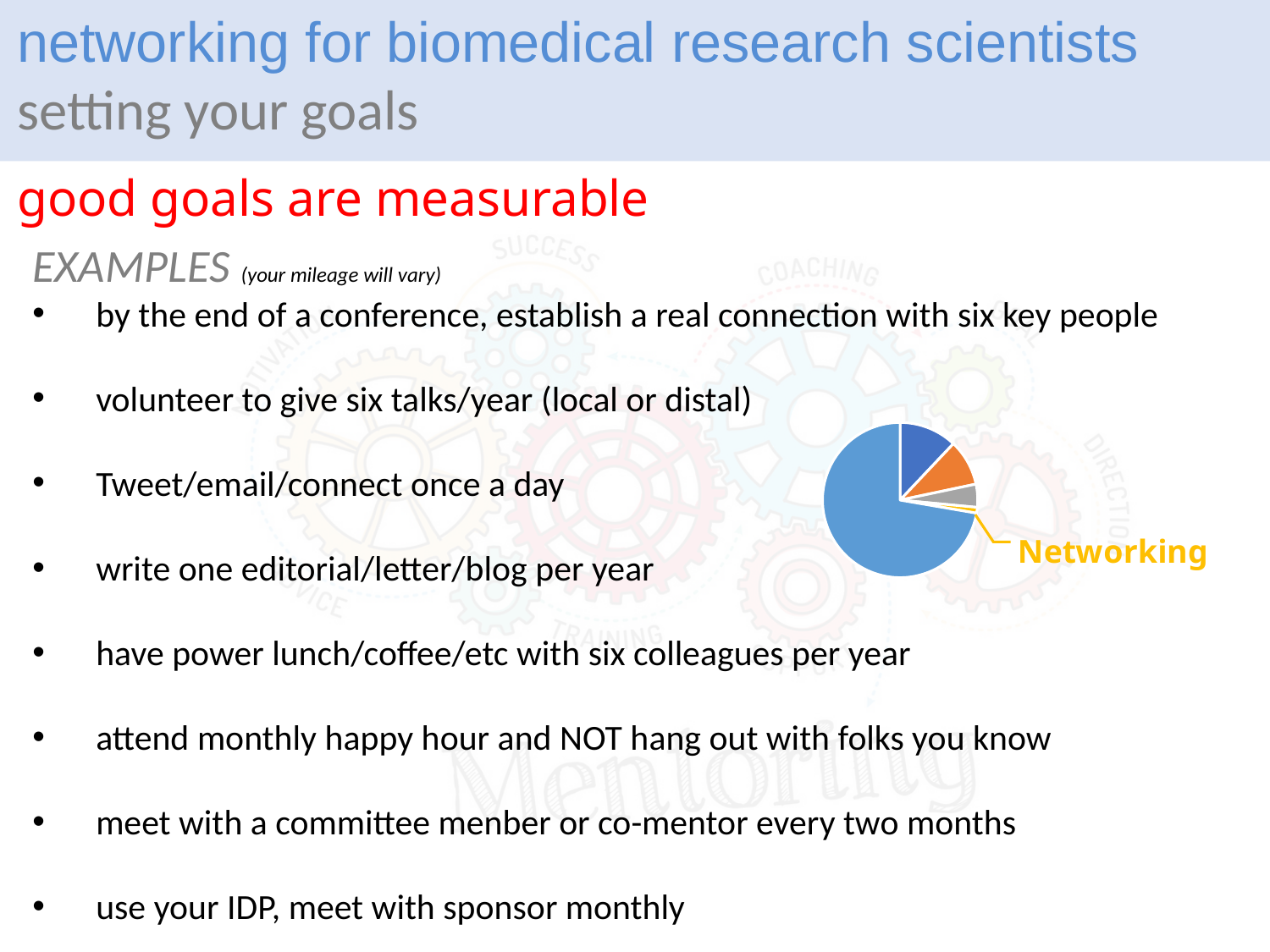
What is the only label shown on the pie chart? Networking Which labeled slice of the pie chart is the smallest? Networking What colour is the slice labeled Networking in the pie chart? yellow Is the Networking slice of the pie chart larger or smaller than the orange slice? smaller How many slices does the pie chart have? 5 What kind of chart is shown on the slide? pie chart